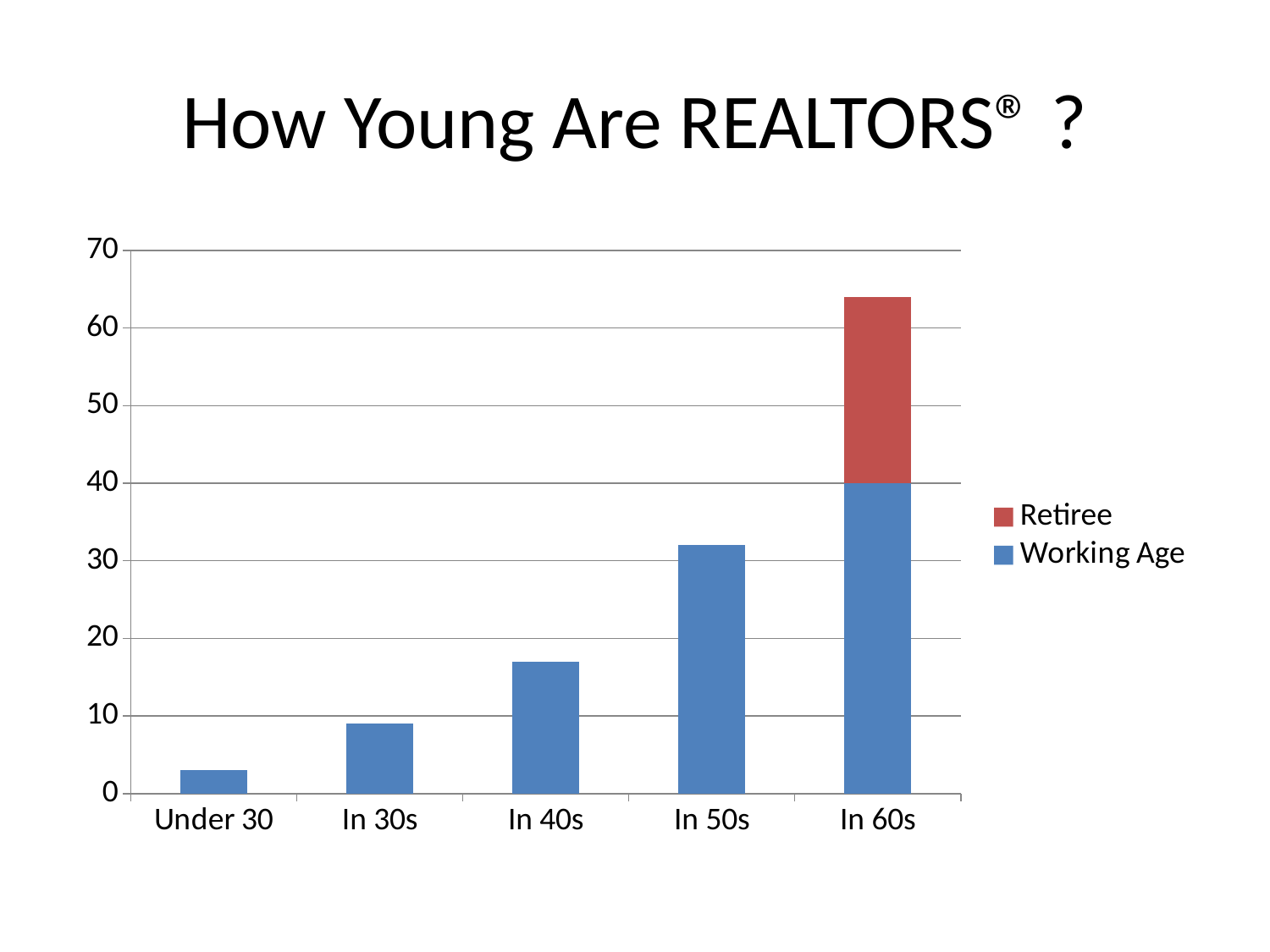
Do the bar heights rise or fall moving from Under 30 to In 60s? rise Is the value for In 50s greater or less than 30? greater What is the Working Age value for the In 60s category? 40 How many series does the legend list? 2 Which is larger, the bar for In 40s or the bar for In 50s? In 50s Which age category has the tallest bar? In 60s How many age categories are shown on the x axis? 5 Is the total height of the In 60s bar greater or less than 60? greater Is the value for Under 30 greater or less than 10? less Which age category has the shortest bar? Under 30 What kind of chart is shown on the slide? bar chart What is the title of the chart? How Young Are REALTORS® ?